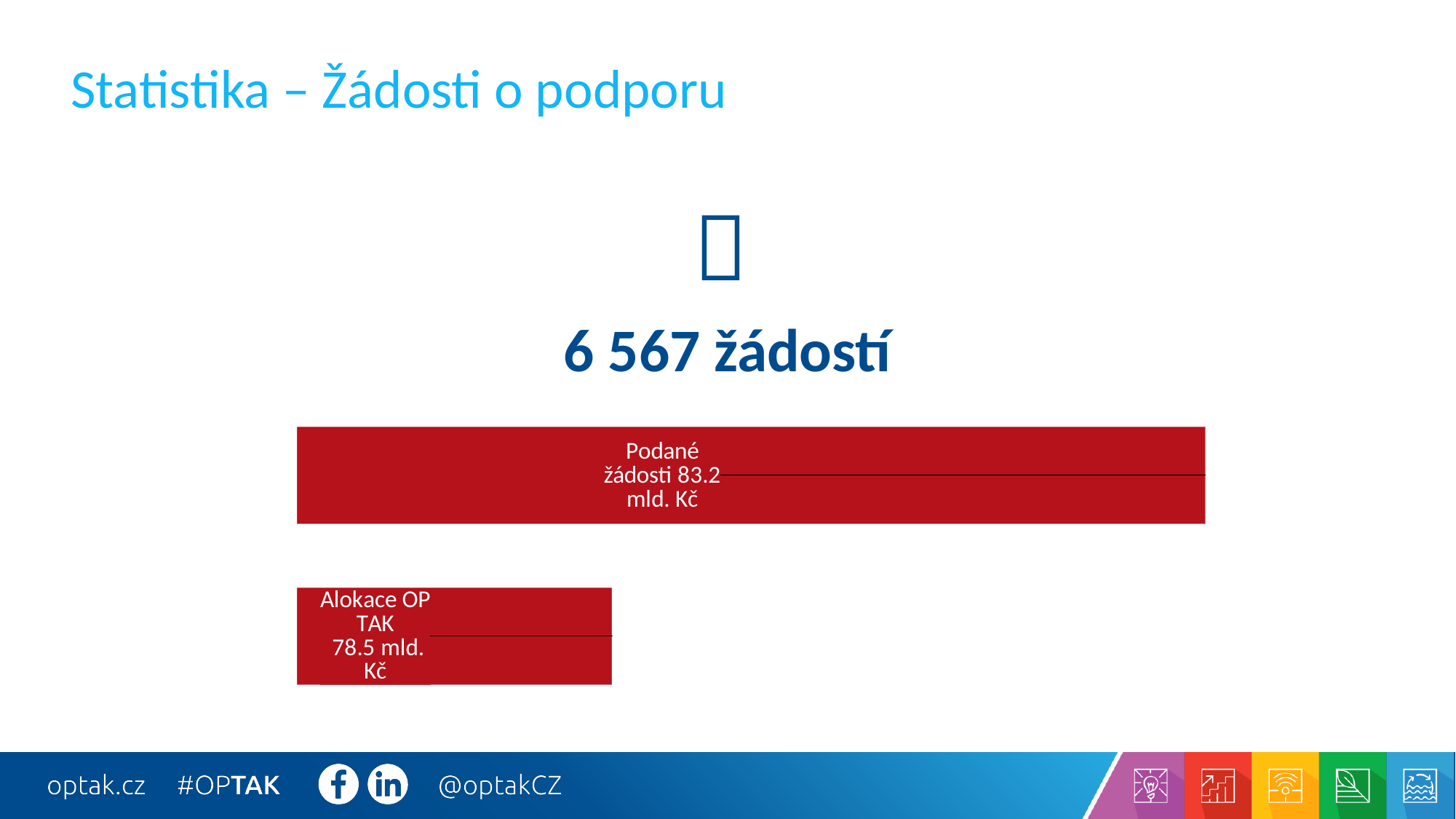
Which category has the highest value in the chart? Podané žádosti What value is shown for Podané žádosti? 83.2 mld. Kč How many applications (žádostí) are stated above the chart? 6 567 žádostí What value is shown for Alokace OP TAK? 78.5 mld. Kč What colour are the bars in the chart? Red Which bar has the higher value, Podané žádosti or Alokace OP TAK? Podané žádosti What is the title of the slide containing the chart? Statistika – Žádosti o podporu What kind of chart is shown on the slide? Bar chart Which category has the lowest value in the chart? Alokace OP TAK What is the difference between the value for Podané žádosti and the value for Alokace OP TAK? 4.7 mld. Kč How many bars are shown in the chart? 2